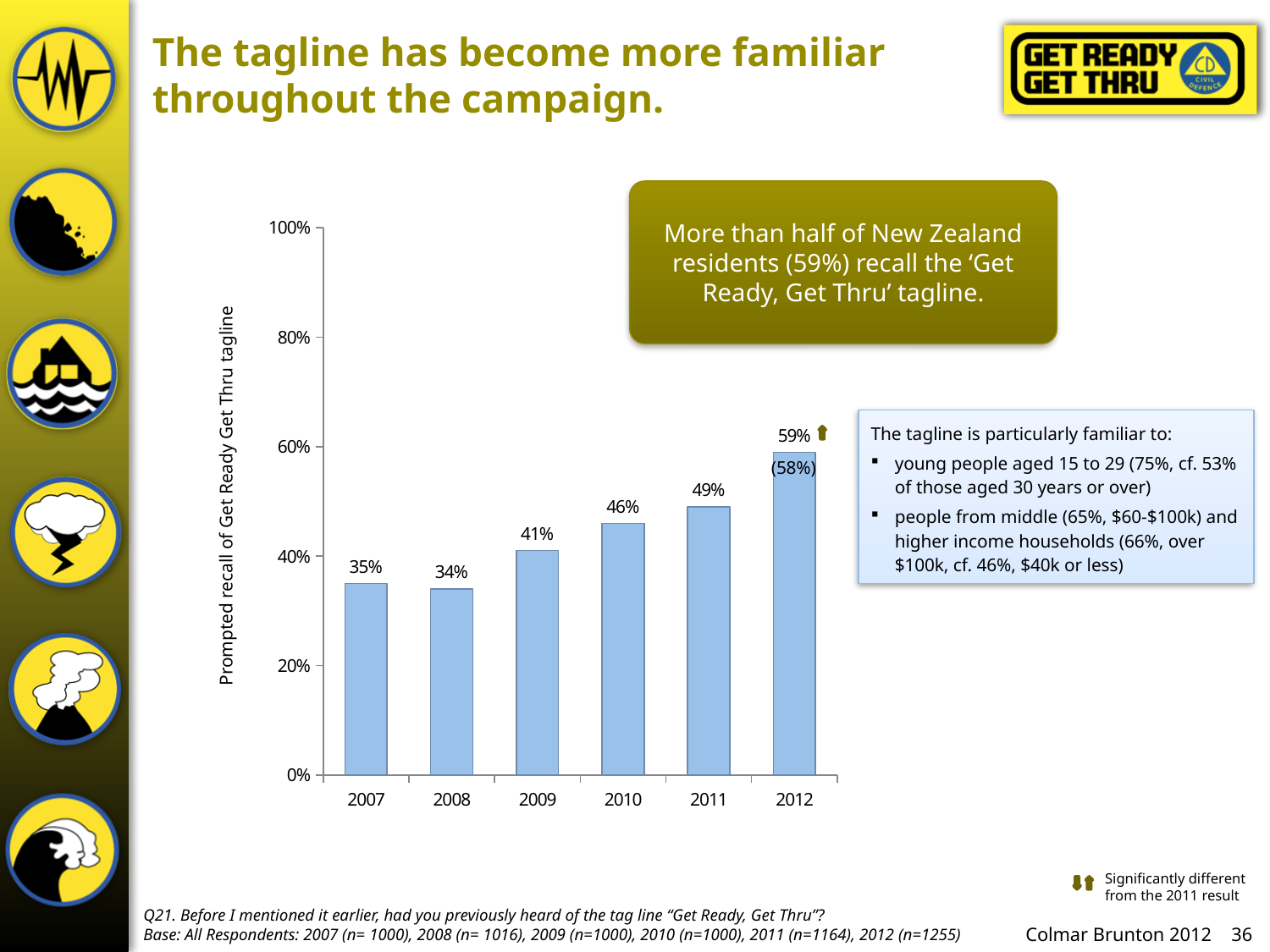
What is the label on the y axis of the chart? Prompted recall of Get Ready Get Thru tagline Which year has the highest prompted recall of the tagline? 2012 How many years are shown on the x axis of the chart? 6 What is the prompted recall of the Get Ready Get Thru tagline in 2012? 59% What is the difference in prompted recall between 2010 and 2007? 11% Which year has a higher prompted recall, 2009 or 2010? 2010 What is the prompted recall value shown for 2007? 35% What is the difference in prompted recall between 2012 and 2011? 10% What kind of chart is used to show prompted recall of the tagline? Bar chart Which year has the lowest prompted recall of the tagline? 2008 Does prompted recall of the tagline generally rise or fall from 2007 to 2012? Rise What is the prompted recall value shown for 2009? 41%